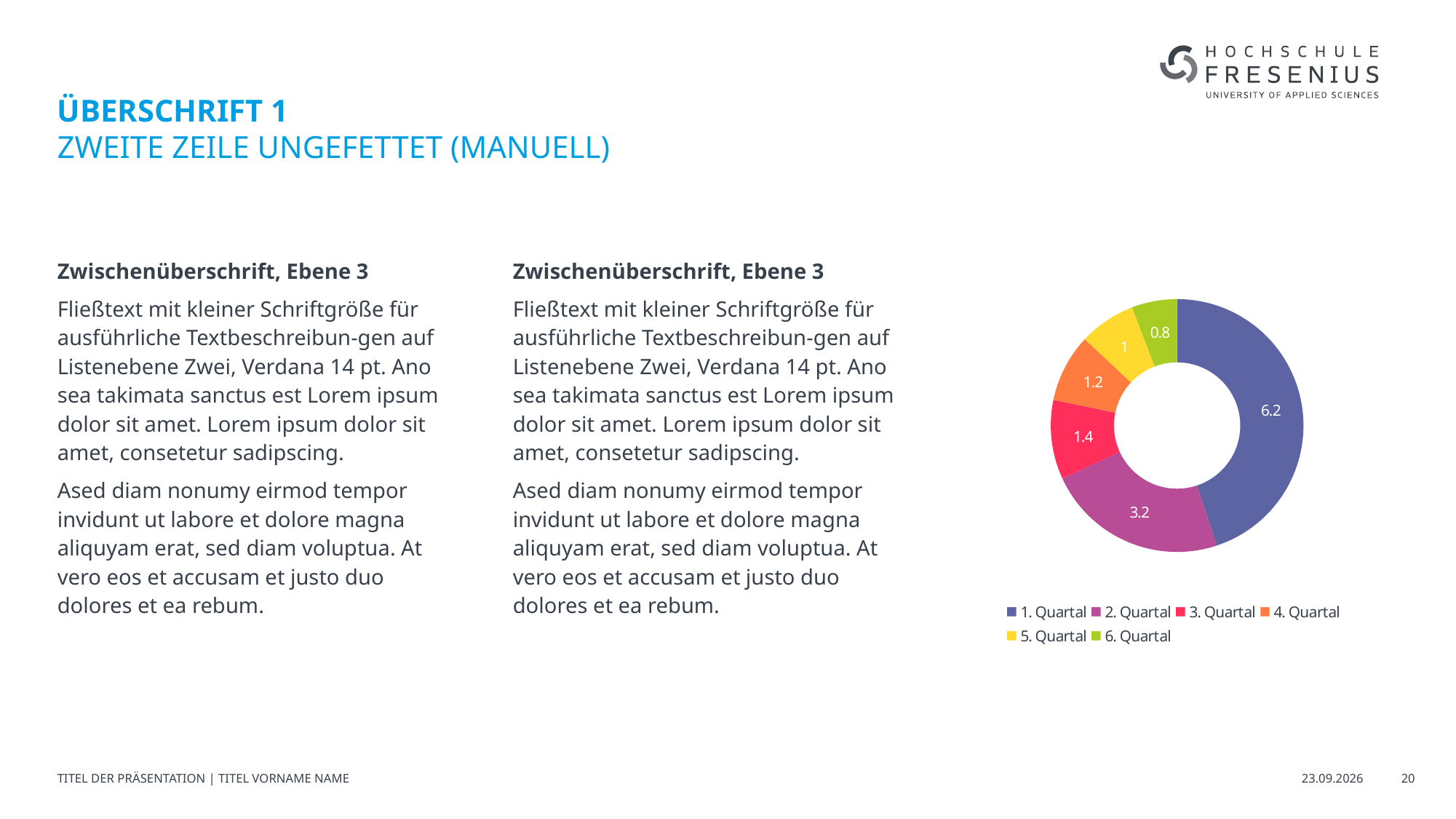
What is the value for 6. Quartal in the doughnut chart? 0.8 What is the difference between the values for 3. Quartal and 5. Quartal? 0.4 How many categories does the doughnut chart show? 6 What is the value for 1. Quartal in the doughnut chart? 6.2 Which is larger, the value for 3. Quartal or the value for 4. Quartal? 3. Quartal What is the total of all slice values in the doughnut chart? 13.8 What is the value for 2. Quartal in the doughnut chart? 3.2 Which category has the largest slice in the doughnut chart? 1. Quartal What kind of chart is shown on the slide? Doughnut chart What is the difference between the values for 1. Quartal and 2. Quartal? 3 What is the value for 4. Quartal in the doughnut chart? 1.2 Which category has the smallest slice in the doughnut chart? 6. Quartal